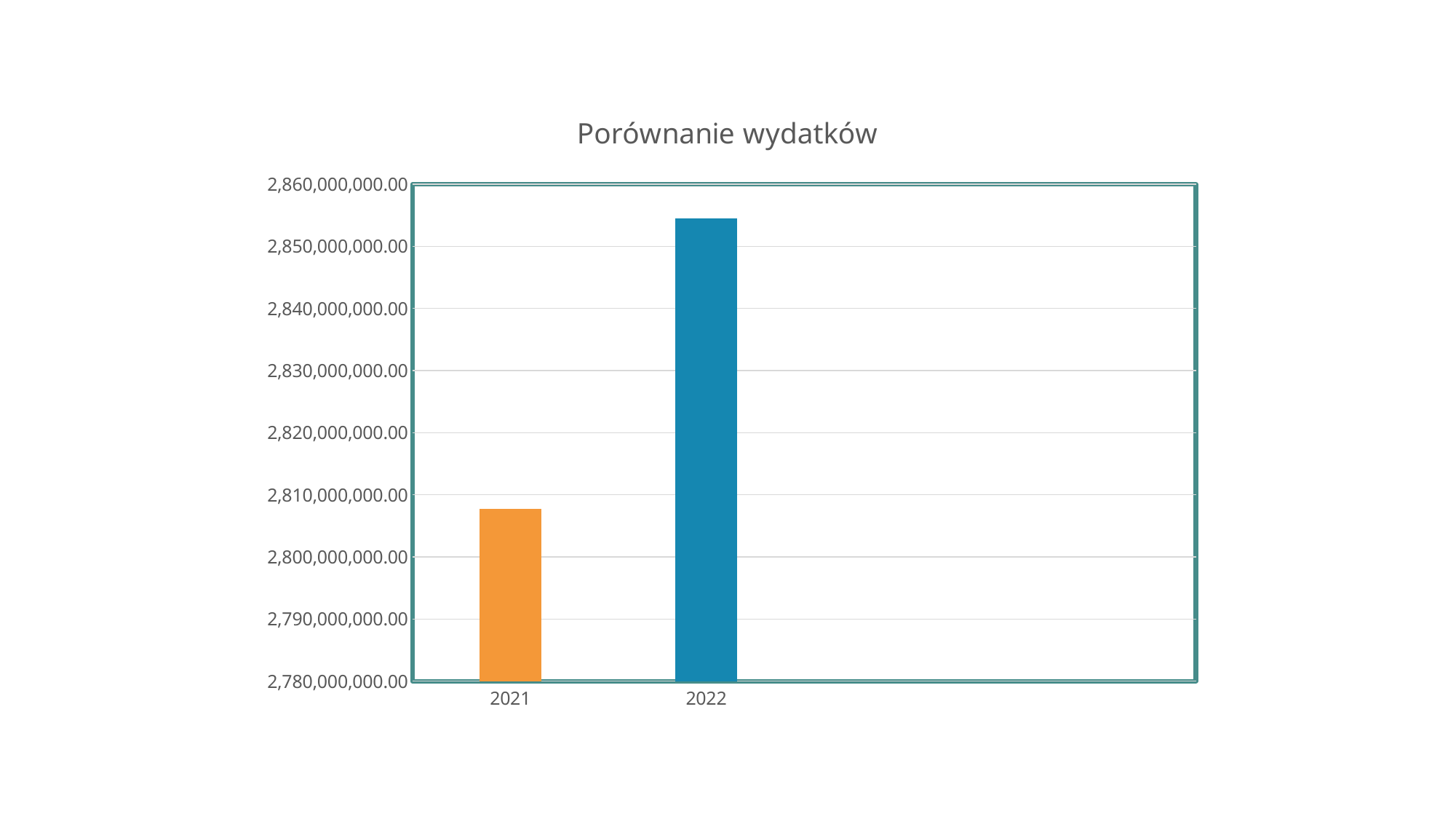
Is the value for 2022 greater or less than 2,860,000,000.00? less Is the value for 2021 greater or less than 2,810,000,000.00? less Is the value for 2021 greater or less than 2,800,000,000.00? greater What colour is the bar for 2021? orange Which year has the lowest value? 2021 Do the values rise or fall from 2021 to 2022? rise What is the title of the chart? Porównanie wydatków Which year has the highest value? 2022 Which is larger, the value for 2021 or the value for 2022? 2022 How many categories are shown on the x axis? 2 What kind of chart is shown on the slide? bar chart